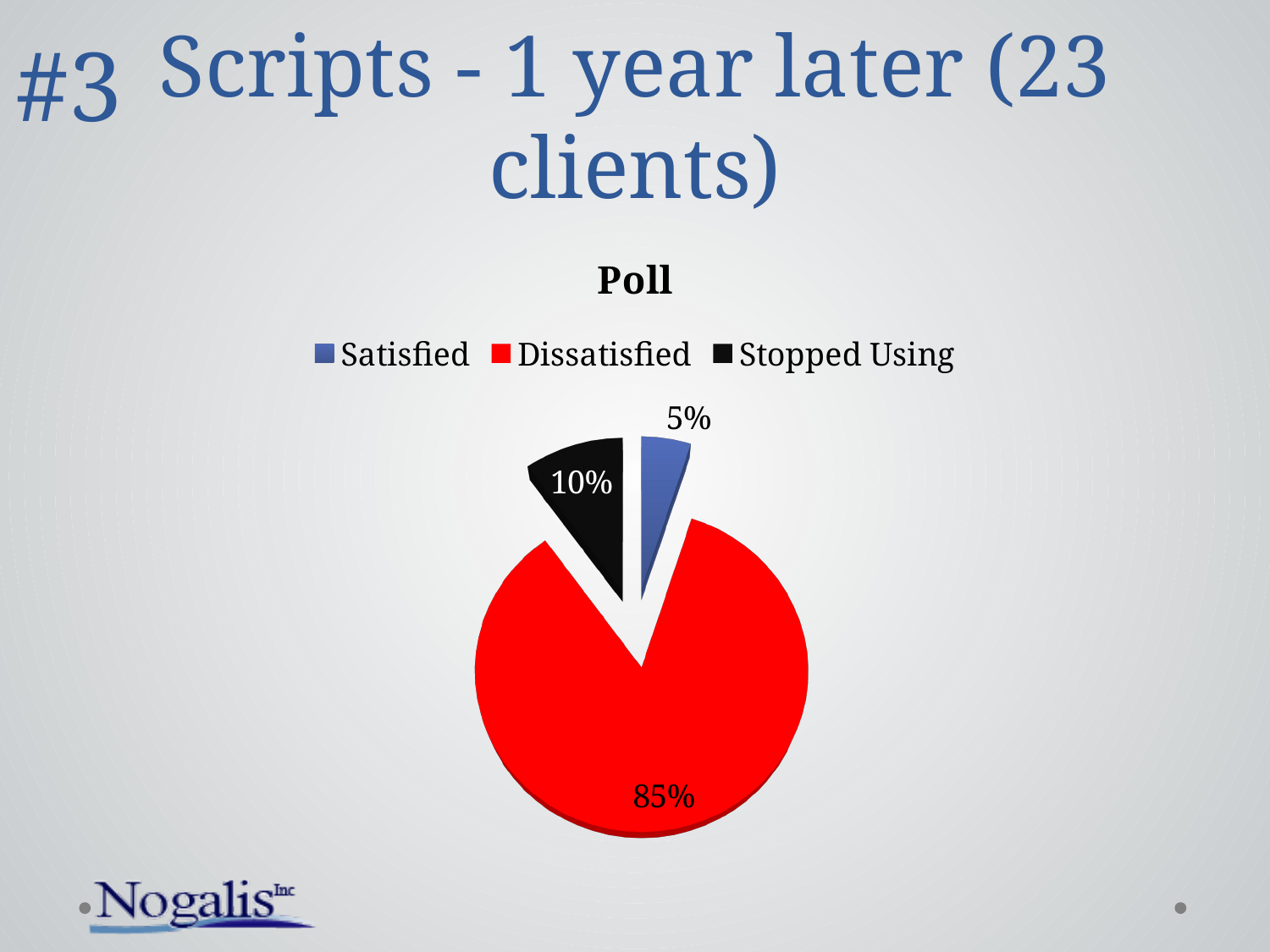
Which category has the smallest slice of the pie? Satisfied What kind of chart is shown on the slide? pie chart What percentage of the pie is labelled Satisfied? 5% What is the difference in percentage points between the Dissatisfied and Stopped Using slices? 75 Which category has the largest slice of the pie? Dissatisfied What colour is the Dissatisfied slice? red Which slice is larger, Stopped Using or Satisfied? Stopped Using What percentage of the pie is labelled Dissatisfied? 85% How many entries does the legend list? 3 What is the title of the chart? Poll What percentage of the pie is labelled Stopped Using? 10% How many slices does the pie chart have? 3